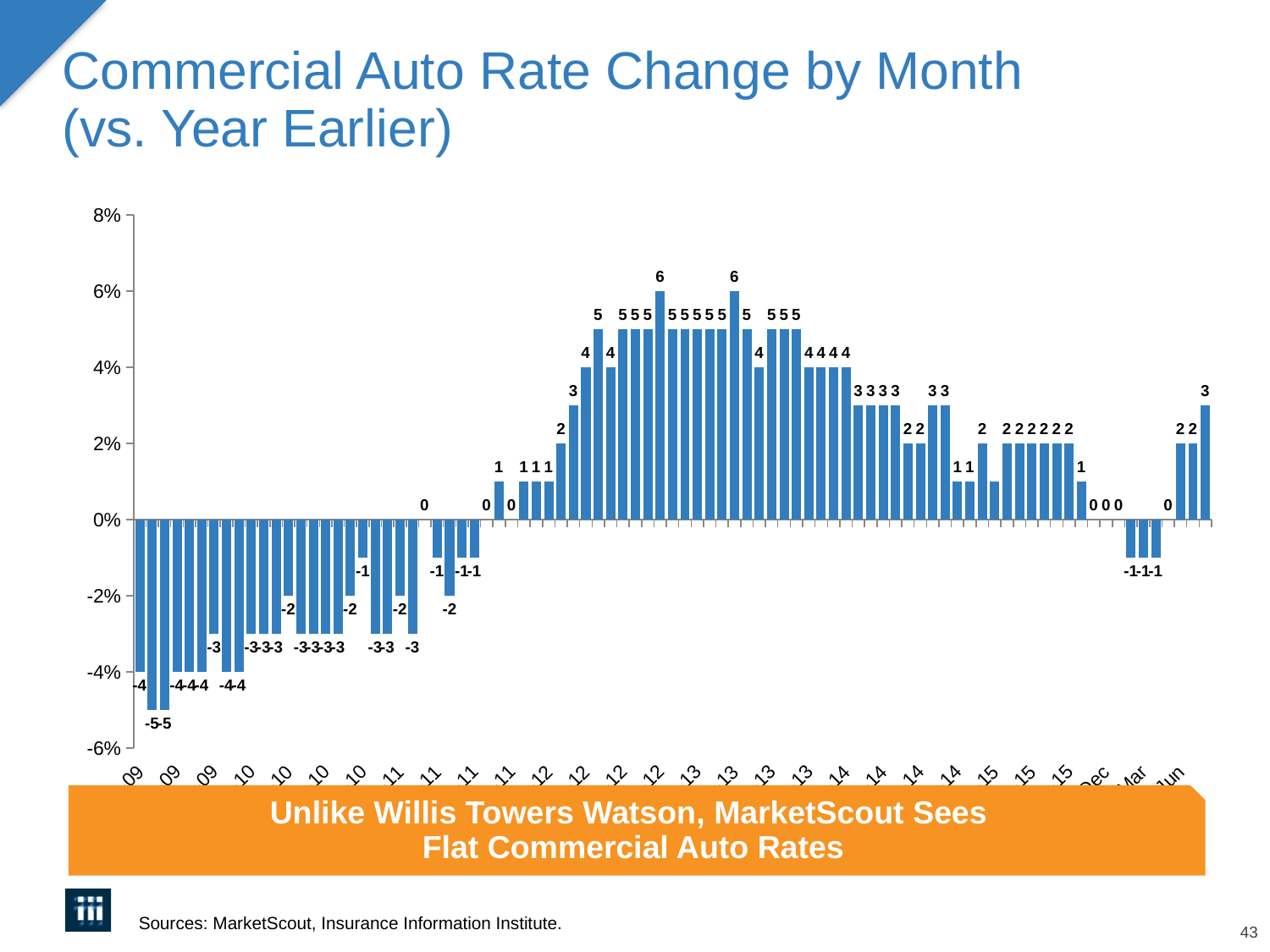
What does the orange banner below the chart say? Unlike Willis Towers Watson, MarketScout Sees Flat Commercial Auto Rates Is the tallest bar in the chart greater or less than 4%? greater What is the value labelled on the rightmost bar of the chart? 3 What is the highest value labelled on any bar in the chart? 6 What is the title of the chart on the slide? Commercial Auto Rate Change by Month (vs. Year Earlier) Do the bar values rise or fall from the leftmost 2009 bars to the 2012 bars? rise What is the highest tick value shown on the vertical axis? 8% What is the lowest value labelled on any bar in the chart? -5 What is the value labelled on the leftmost bar of the chart? -4 How many bars in the chart are labelled with the value 6? 2 What kind of chart is shown on the slide? bar chart What is the difference between the highest labelled bar value (6) and the lowest labelled bar value (-5)? 11